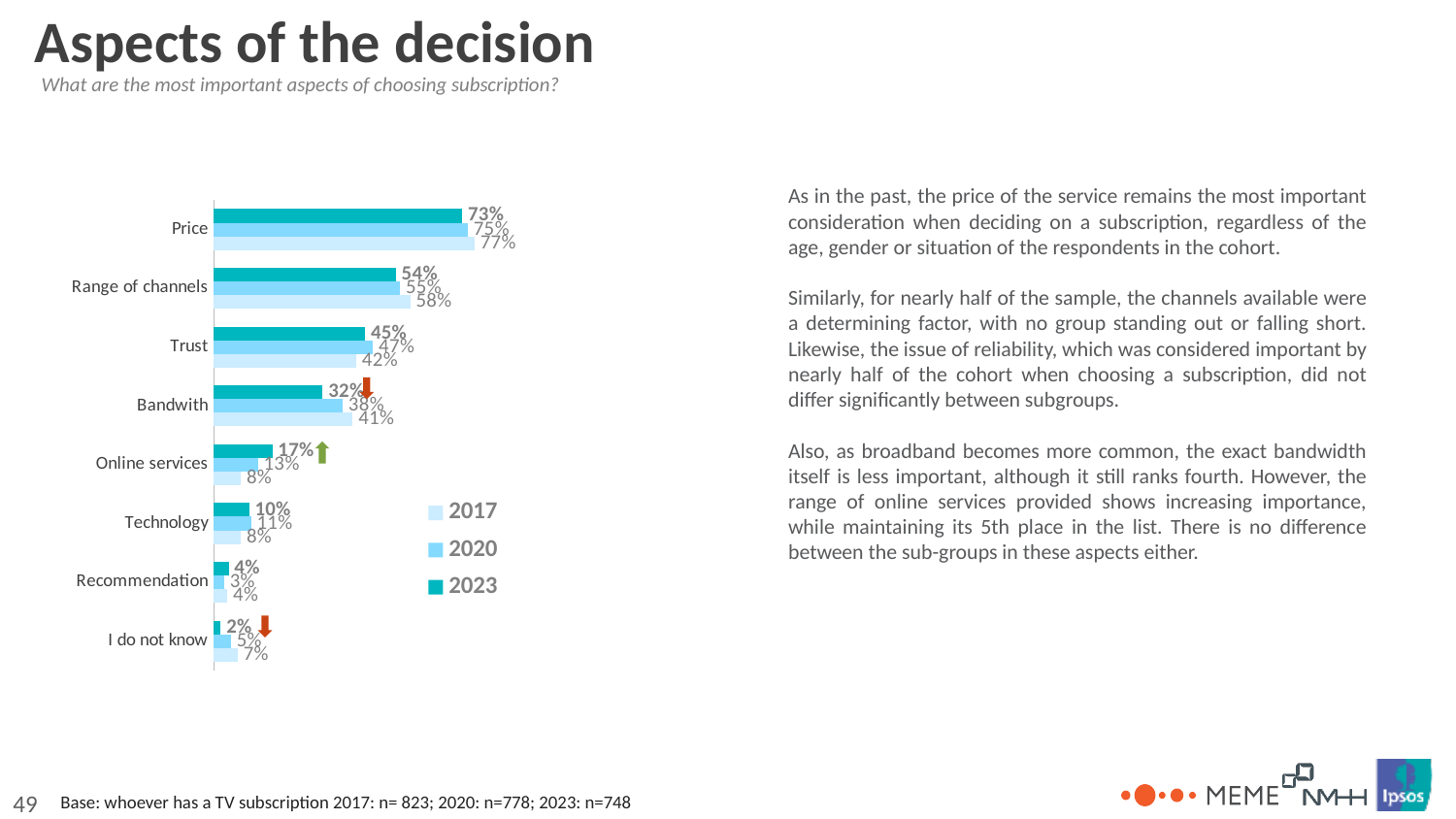
What is the 2023 value for Price? 73% Which category has the lowest 2023 value? I do not know What is the 2020 value for Bandwith? 38% Which category has the highest 2023 value? Price Is the 2023 value for Online services larger than the 2017 value for Online services? Yes What is the difference between the 2017 and 2023 values for Bandwith? 9% What is the 2017 value for Range of channels? 58% Which series is shown in the darkest colour in the legend? 2023 How many categories are shown on the chart? 8 What kind of chart is shown on the slide? bar chart How many series does the legend list? 3 What is the difference between the 2023 and 2017 values for Online services? 9%